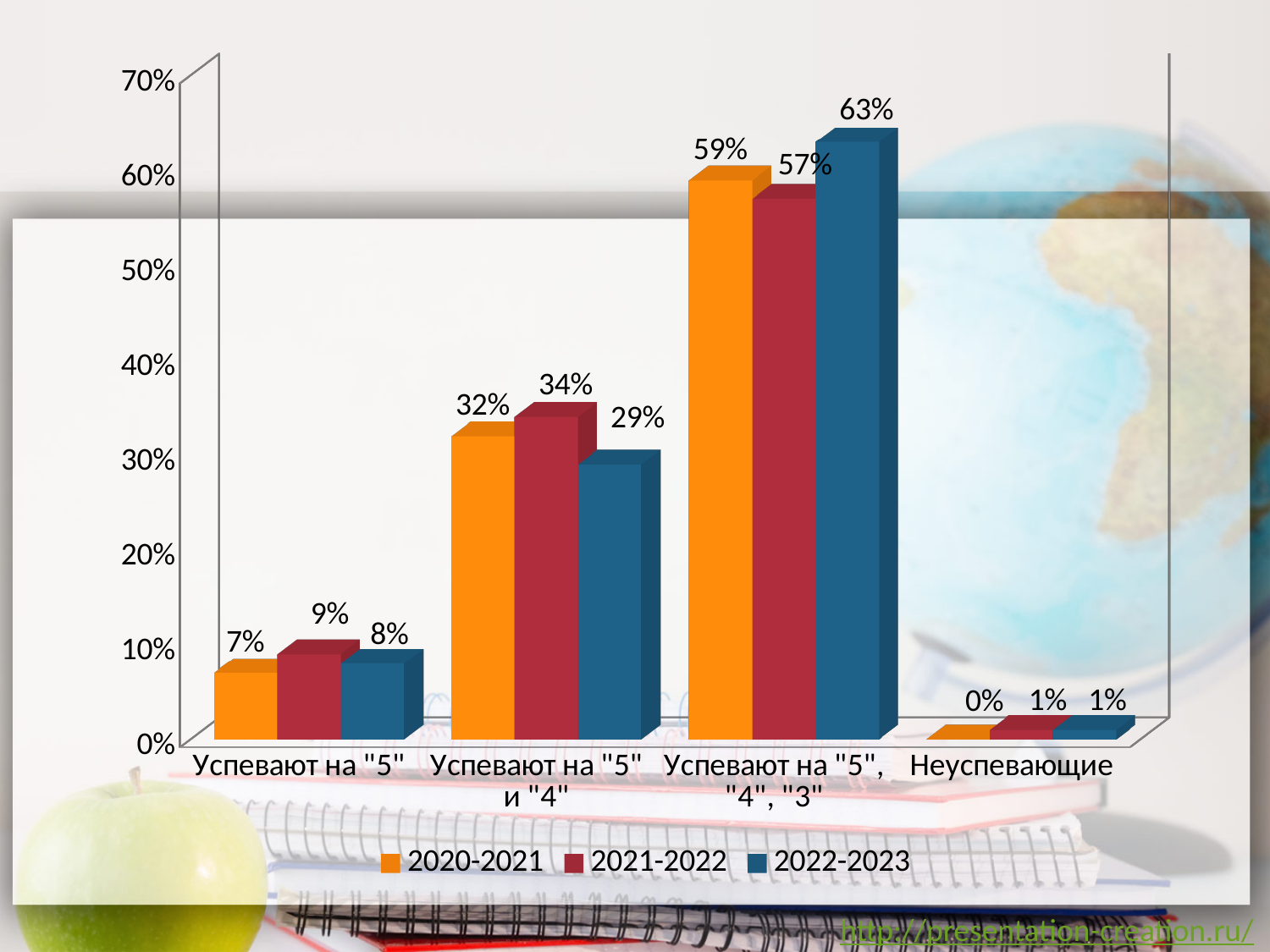
Which series has the lowest value in the category Успевают на "5" и "4"? 2022-2023 How many categories are shown on the x axis? 4 What is the difference between the 2022-2023 and 2021-2022 values in the category Успевают на "5", "4", "3"? 6% Is the value for 2020-2021 in the category Успевают на "5" и "4" greater or less than 40%? less Which colour represents the 2022-2023 series in the legend? blue Which is larger in the category Успевают на "5": the 2021-2022 value or the 2020-2021 value? 2021-2022 What is the value for 2020-2021 in the category Неуспевающие? 0% What is the value for 2022-2023 in the category Успевают на "5", "4", "3"? 63% What is the value for 2021-2022 in the category Успевают на "5" и "4"? 34% What kind of chart is shown on the slide? bar chart How many series does the legend list? 3 Which category has the highest value for the 2020-2021 series? Успевают на "5", "4", "3"